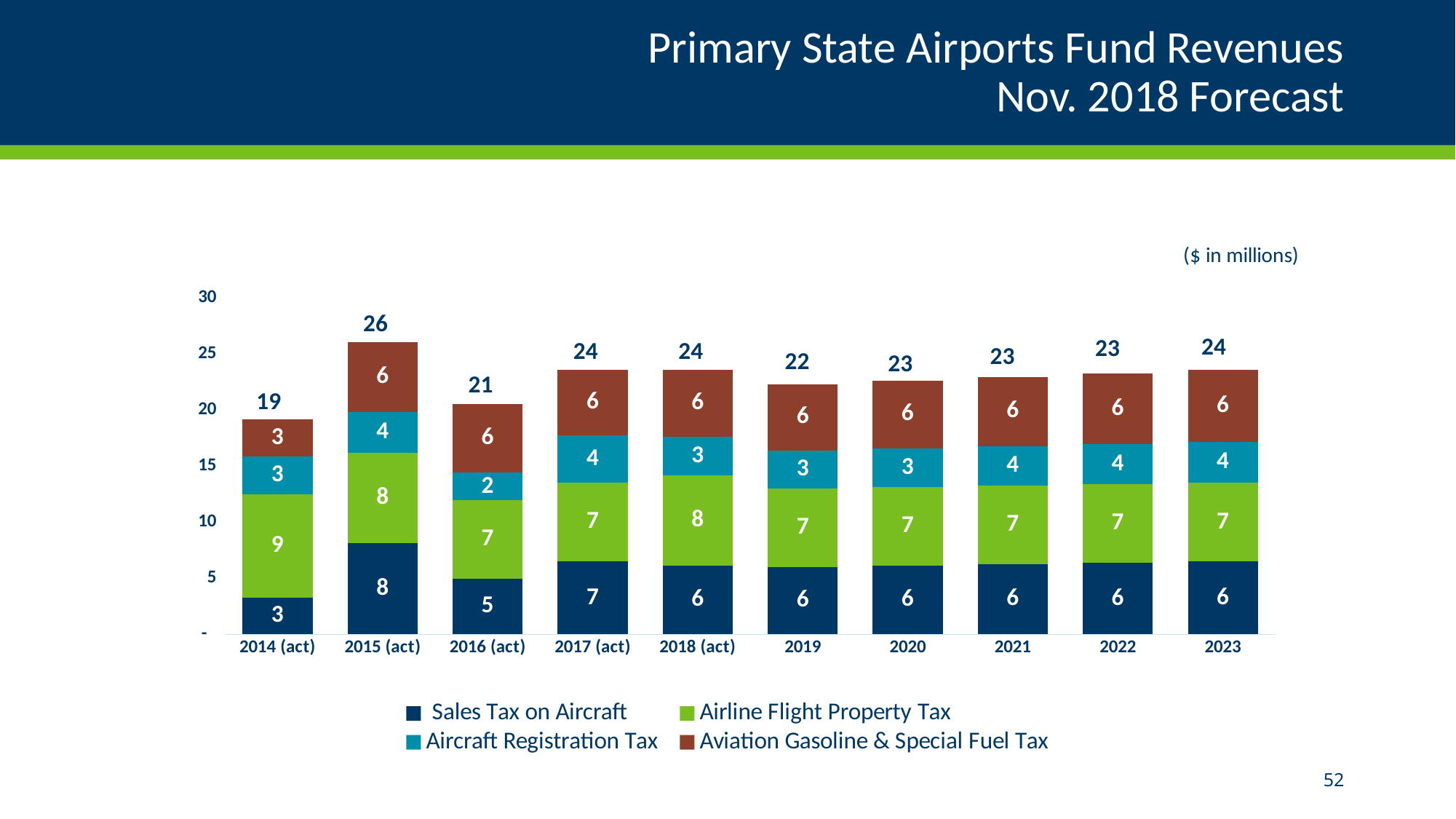
What kind of chart is shown on the slide? Stacked bar chart What is the difference between the total for 2015 (act) and the total for 2016 (act)? 5 What is the Sales Tax on Aircraft value for 2015 (act)? 8 Which year has the lowest total revenue? 2014 (act) Which is larger, the Sales Tax on Aircraft value for 2017 (act) or for 2018 (act)? 2017 (act) What is the Aircraft Registration Tax value for 2016 (act)? 2 How many series does the legend list? 4 What is the Aviation Gasoline & Special Fuel Tax value for 2014 (act)? 3 What is the Airline Flight Property Tax value for 2014 (act)? 9 What is the total of the stacked bar for 2015 (act)? 26 Which year has the highest total revenue? 2015 (act) How many years are shown on the x axis? 10